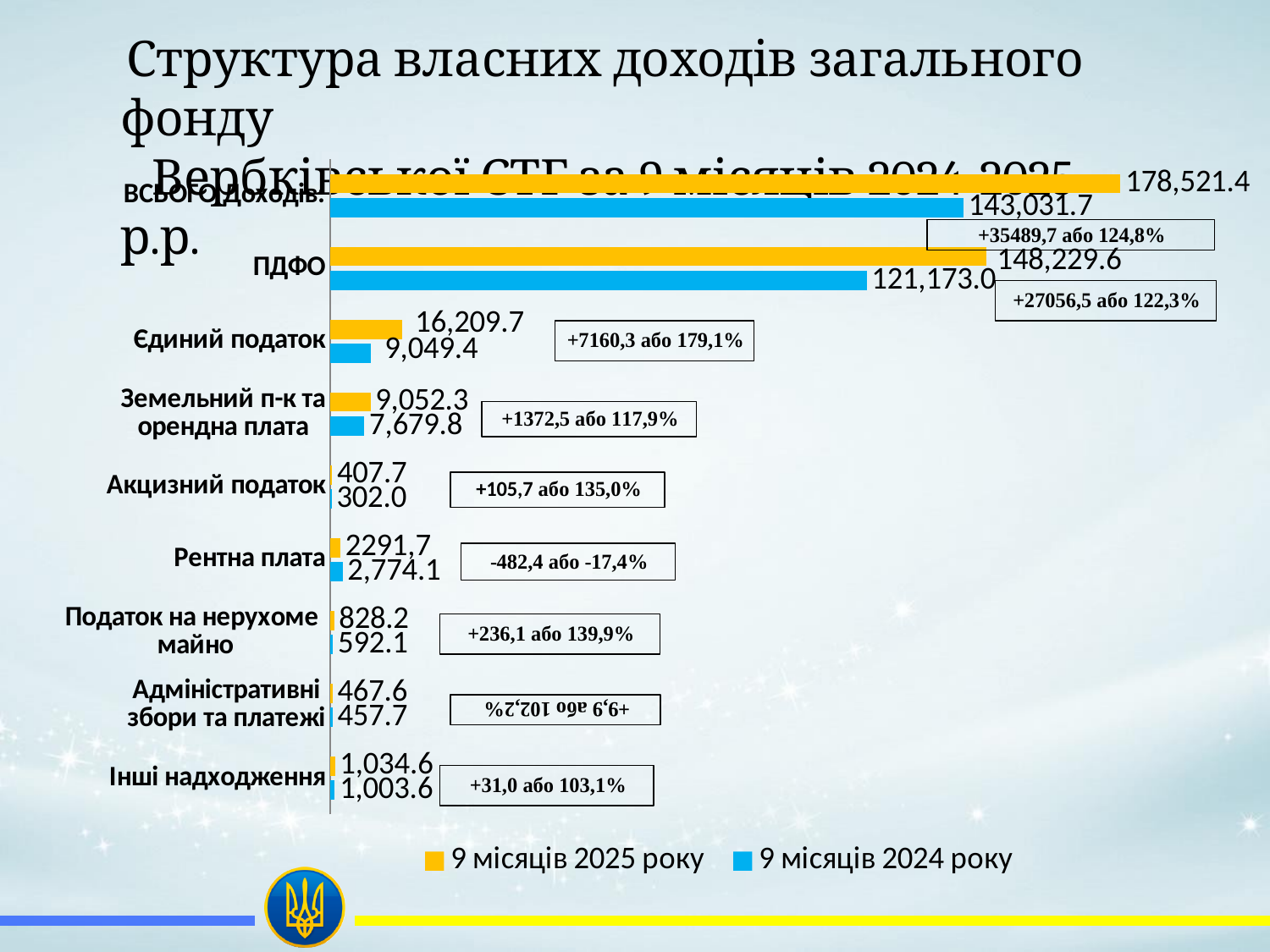
What kind of chart is shown on the slide? Bar chart Which category has the lowest value in the 9 місяців 2025 року series? Акцизний податок What is the value for Єдиний податок in the 9 місяців 2024 року series? 9,049.4 What is the difference between the 9 місяців 2025 року and 9 місяців 2024 року values for Земельний п-к та орендна плата? 1,372.5 How many categories are shown on the chart? 9 What is the value for Рентна плата in the 9 місяців 2025 року series? 2291,7 What is the value for ВСЬОГО доходів in the 9 місяців 2024 року series? 143,031.7 How many series does the legend list? 2 What is the difference between the 9 місяців 2025 року and 9 місяців 2024 року values for Єдиний податок? 7,160.3 For Рентна плата, which series has the larger value: 9 місяців 2025 року or 9 місяців 2024 року? 9 місяців 2024 року Which category has the highest value in the 9 місяців 2024 року series? ВСЬОГО доходів What is the value for ПДФО in the 9 місяців 2025 року series? 148,229.6